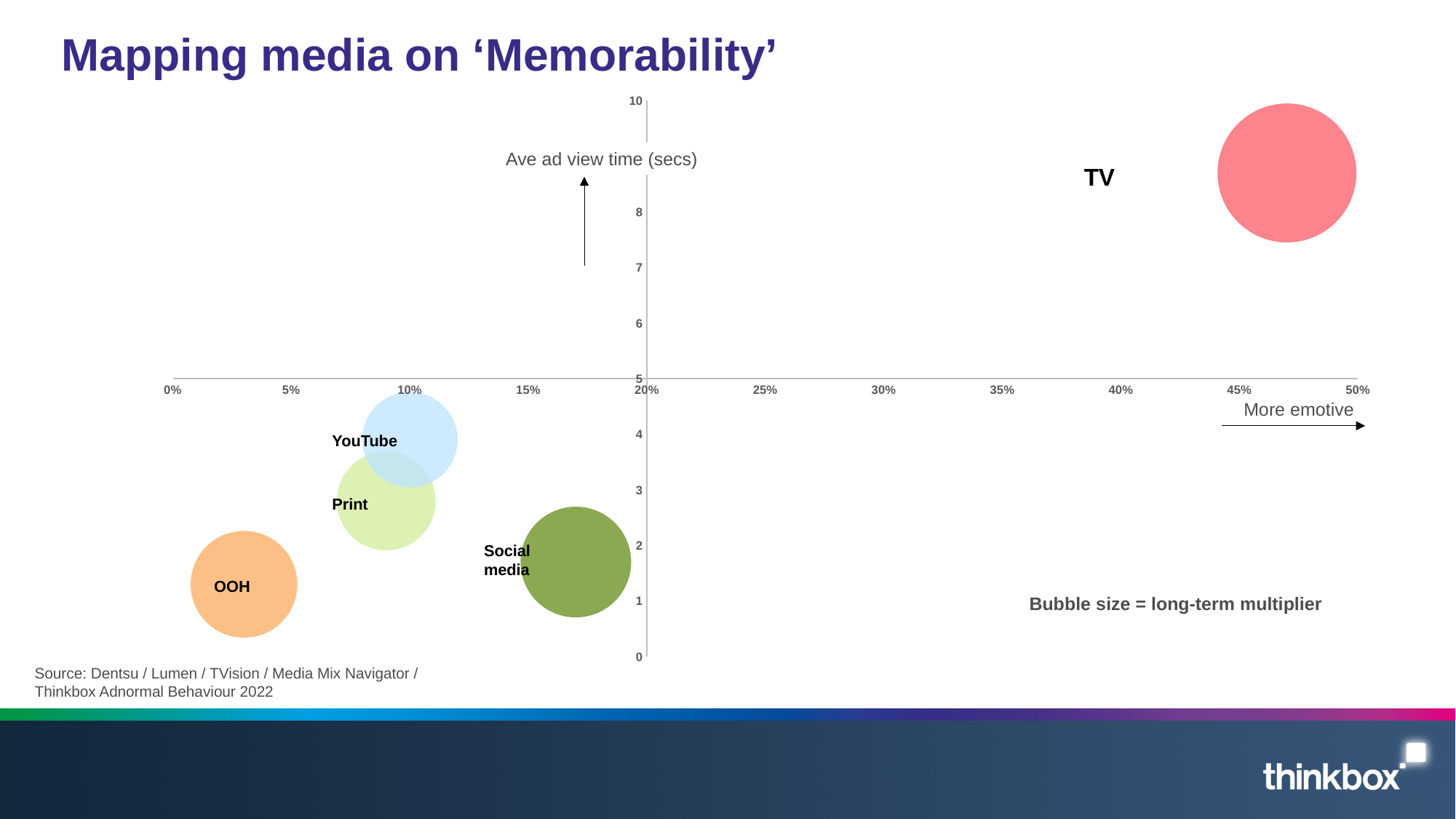
Which bubble is the largest on the chart? TV Is the horizontal (emotive) value for OOH greater or less than 5%? less Is the average ad view time for YouTube greater or less than 3 seconds? greater Which medium is plotted furthest to the left on the 'More emotive' axis? OOH Which medium is plotted furthest to the right (most emotive) on the chart? TV What kind of chart is shown on the slide? Bubble chart According to the chart note, what does the bubble size represent? Long-term multiplier How many media bubbles are plotted on the chart? 5 Is the horizontal (emotive) value for Social media greater or less than 15%? greater Which medium has the highest average ad view time on the chart? TV Which has a higher average ad view time, YouTube or Print? YouTube